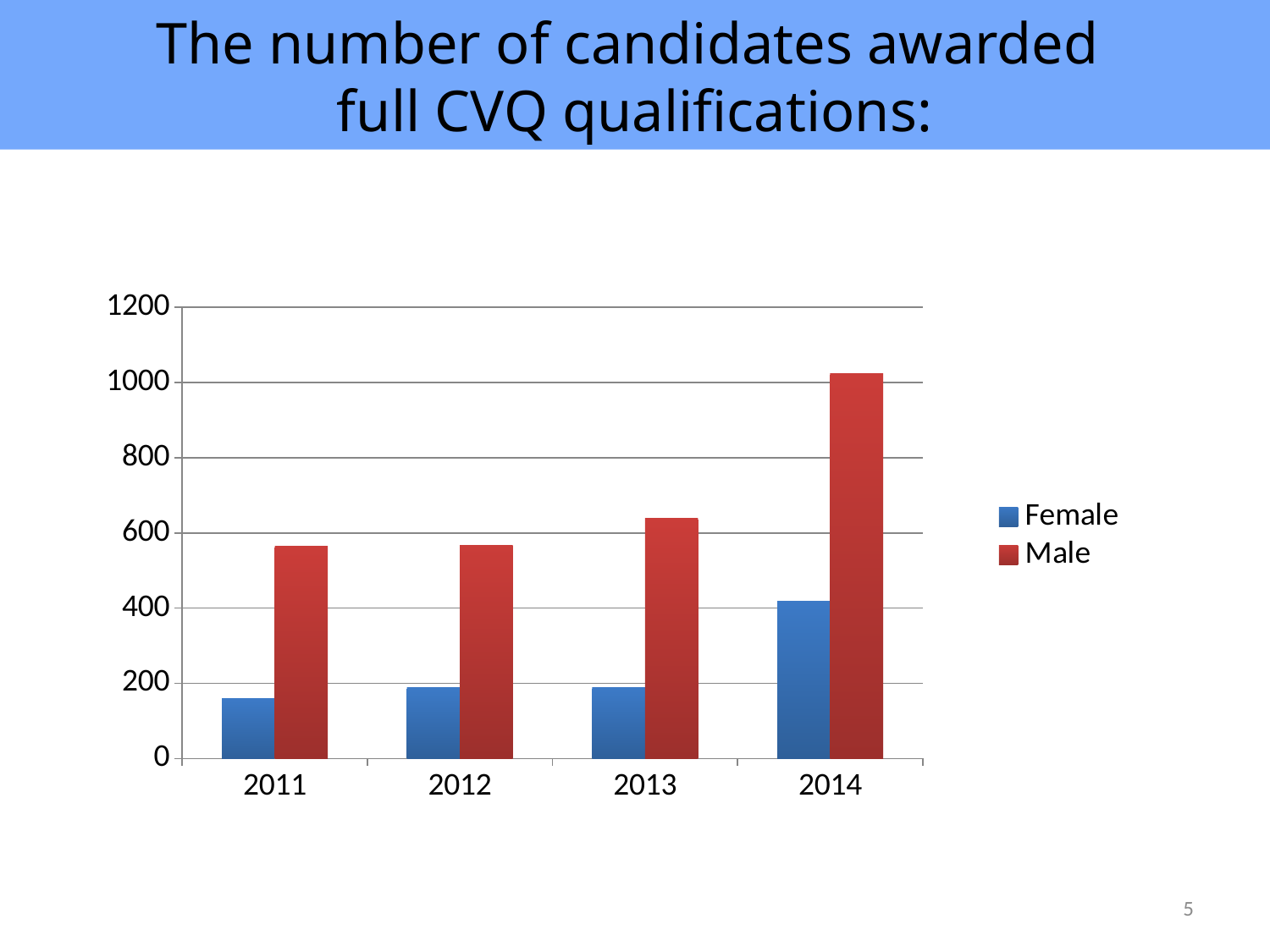
Is the Female value for 2014 greater or less than 400? greater Is the Male value for 2013 greater or less than 600? greater In which year is the Female value highest? 2014 In which year is the Female value lowest? 2011 Do the Male values rise or fall from 2011 to 2014? rise Is the Male value for 2014 greater or less than 1000? greater In which year is the Male value highest? 2014 What kind of chart is shown on the slide? bar chart How many years are shown on the x axis? 4 In 2014, which is larger, the Male value or the Female value? Male How many series does the legend list? 2